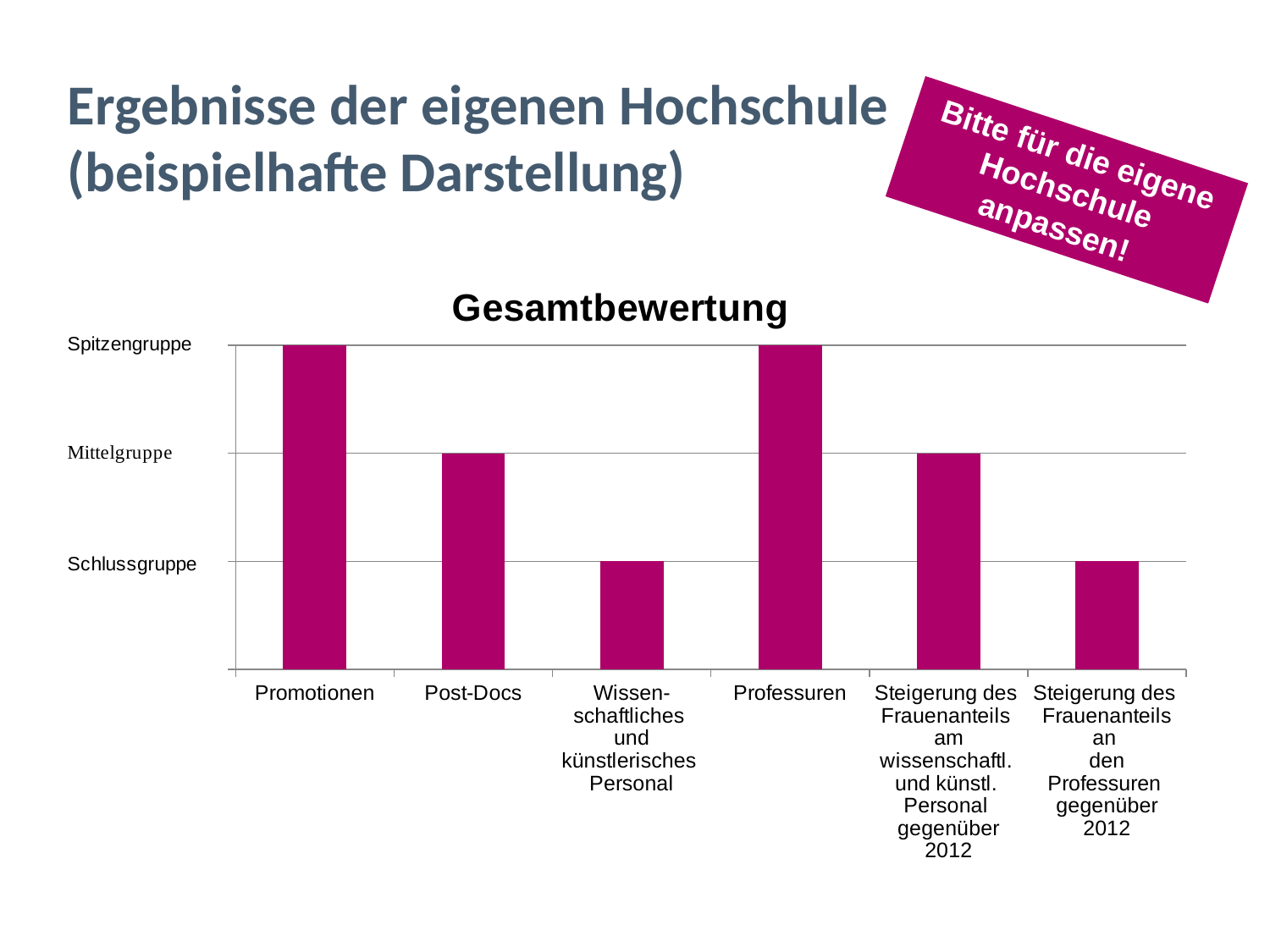
Which group level does the bar for Promotionen reach? Spitzengruppe Which bar is higher, Promotionen or Post-Docs? Promotionen What is the title of the chart? Gesamtbewertung Which bar is lower, Professuren or Steigerung des Frauenanteils an den Professuren gegenüber 2012? Steigerung des Frauenanteils an den Professuren gegenüber 2012 What are the three levels labelled on the y axis of the chart? Spitzengruppe, Mittelgruppe, Schlussgruppe Which group level does the bar for Post-Docs reach? Mittelgruppe Which group level does the bar for Steigerung des Frauenanteils am wissenschaftl. und künstl. Personal gegenüber 2012 reach? Mittelgruppe How many categories are shown on the x axis of the chart? 6 What kind of chart is shown on the slide? Bar chart Which group level does the bar for Wissenschaftliches und künstlerisches Personal reach? Schlussgruppe Which group level does the bar for Professuren reach? Spitzengruppe Which group level does the bar for Steigerung des Frauenanteils an den Professuren gegenüber 2012 reach? Schlussgruppe